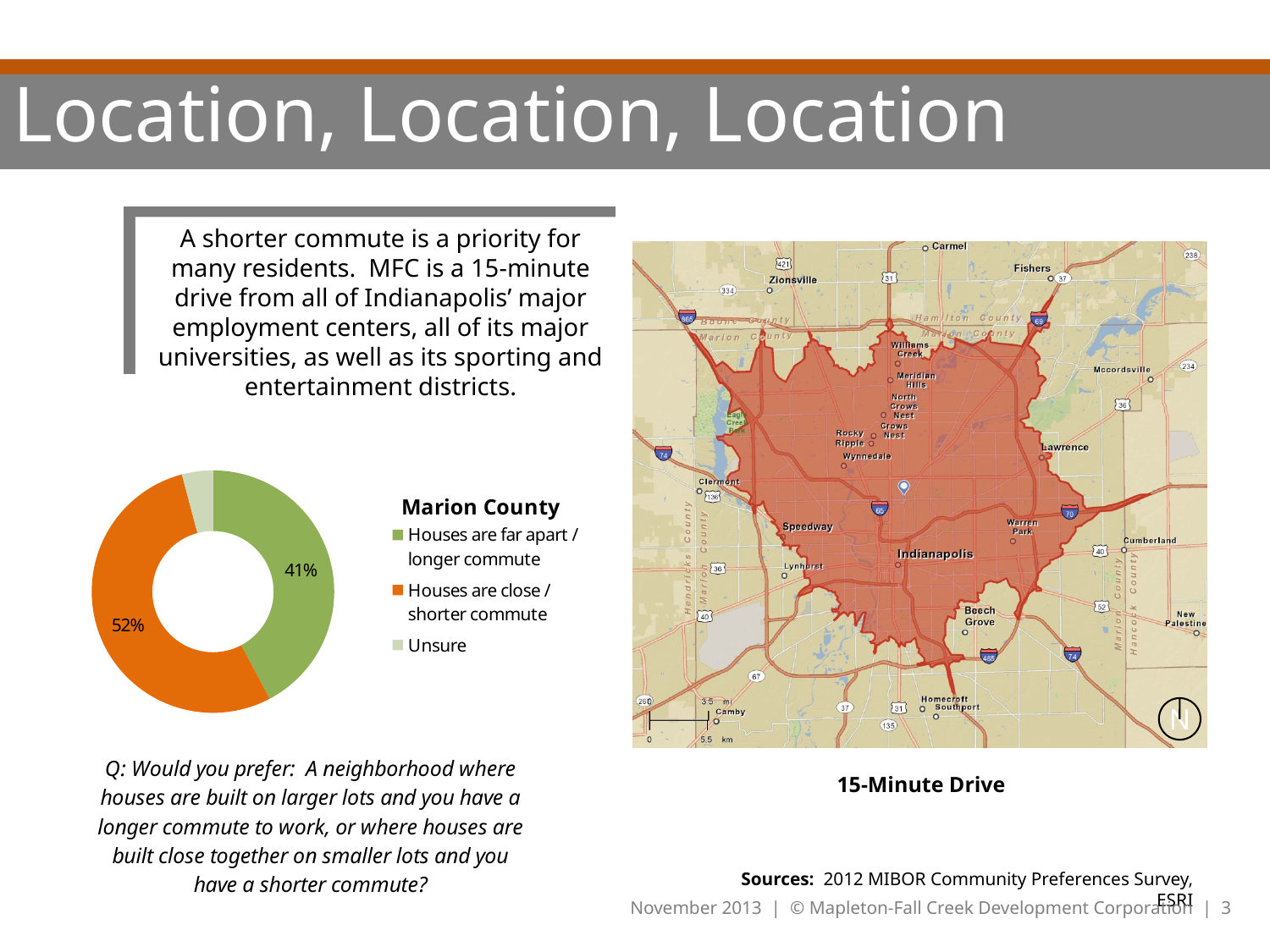
What colour represents "Houses are far apart / longer commute" in the Marion County chart? Green In the Marion County chart, is the share for "Houses are close / shorter commute" greater or less than 50%? greater In the Marion County chart, what percentage of respondents prefer houses that are far apart with a longer commute? 41% In the Marion County chart, what percentage of respondents prefer houses that are close together with a shorter commute? 52% What type of chart is shown under the heading "Marion County"? Pie chart (donut) How many categories does the legend of the Marion County chart list? 3 In the Marion County chart, what is the difference in percentage points between "Houses are close / shorter commute" and "Houses are far apart / longer commute"? 11 percentage points Which category has the largest share in the Marion County chart? Houses are close / shorter commute Which category has the smallest share in the Marion County chart? Unsure In the Marion County chart, which is larger: the share for "Houses are far apart / longer commute" or the share for "Houses are close / shorter commute"? Houses are close / shorter commute What colour represents "Houses are close / shorter commute" in the Marion County chart? Orange